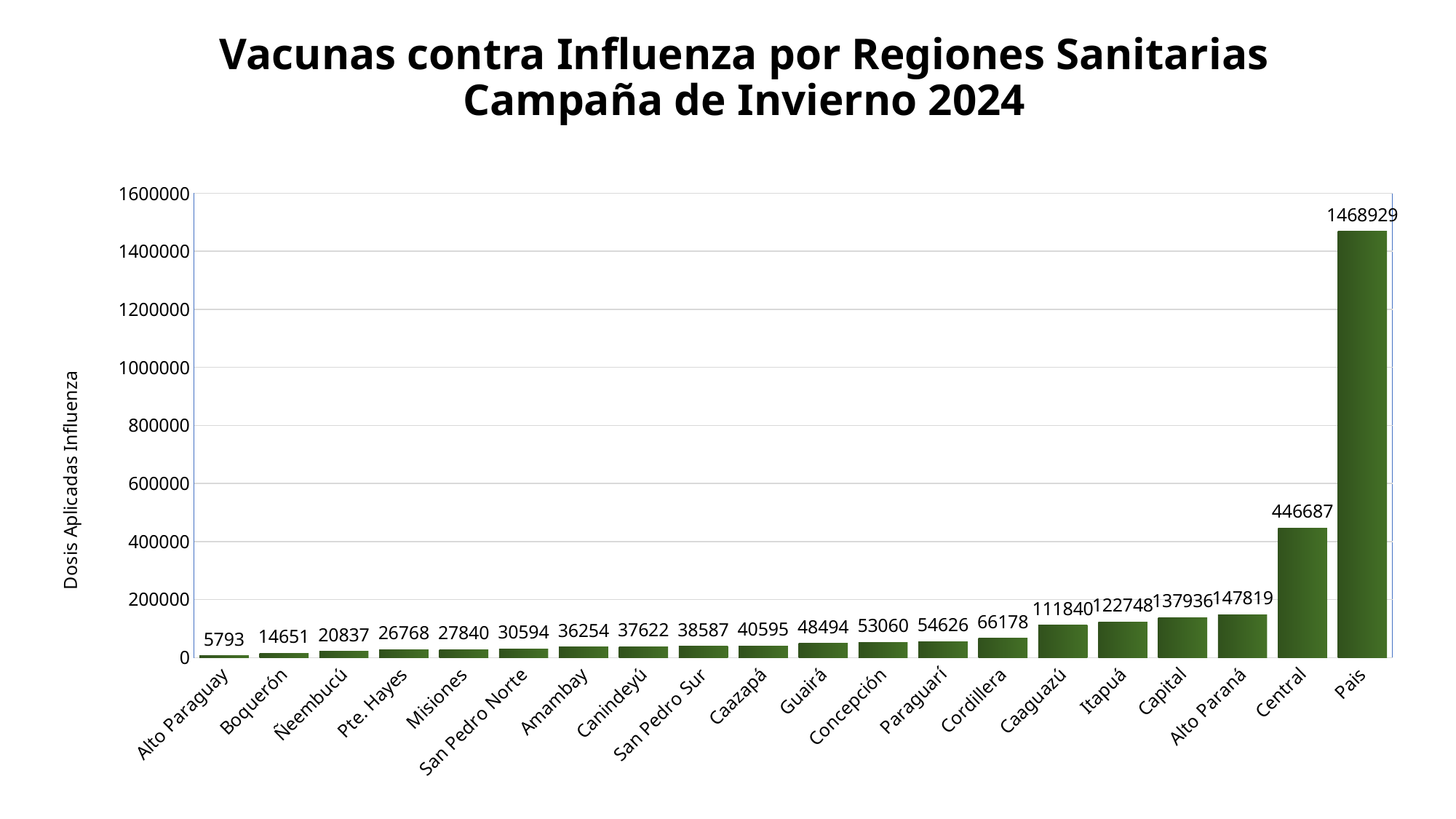
Which category has the highest value? Pais What is the value for Alto Paraguay? 5793 What is the difference between the values for Central and Alto Paraná? 298868 What is the difference between the values for Capital and Itapuá? 15188 What is the value for Caaguazú? 111840 What kind of chart is shown on the slide? bar chart Is the value for Pais greater or less than 1400000? greater What is the value for Central? 446687 Which is larger, the value for Cordillera or the value for Guairá? Cordillera What is the label of the vertical axis? Dosis Aplicadas Influenza How many categories are shown on the x axis? 20 Which category has the lowest value? Alto Paraguay